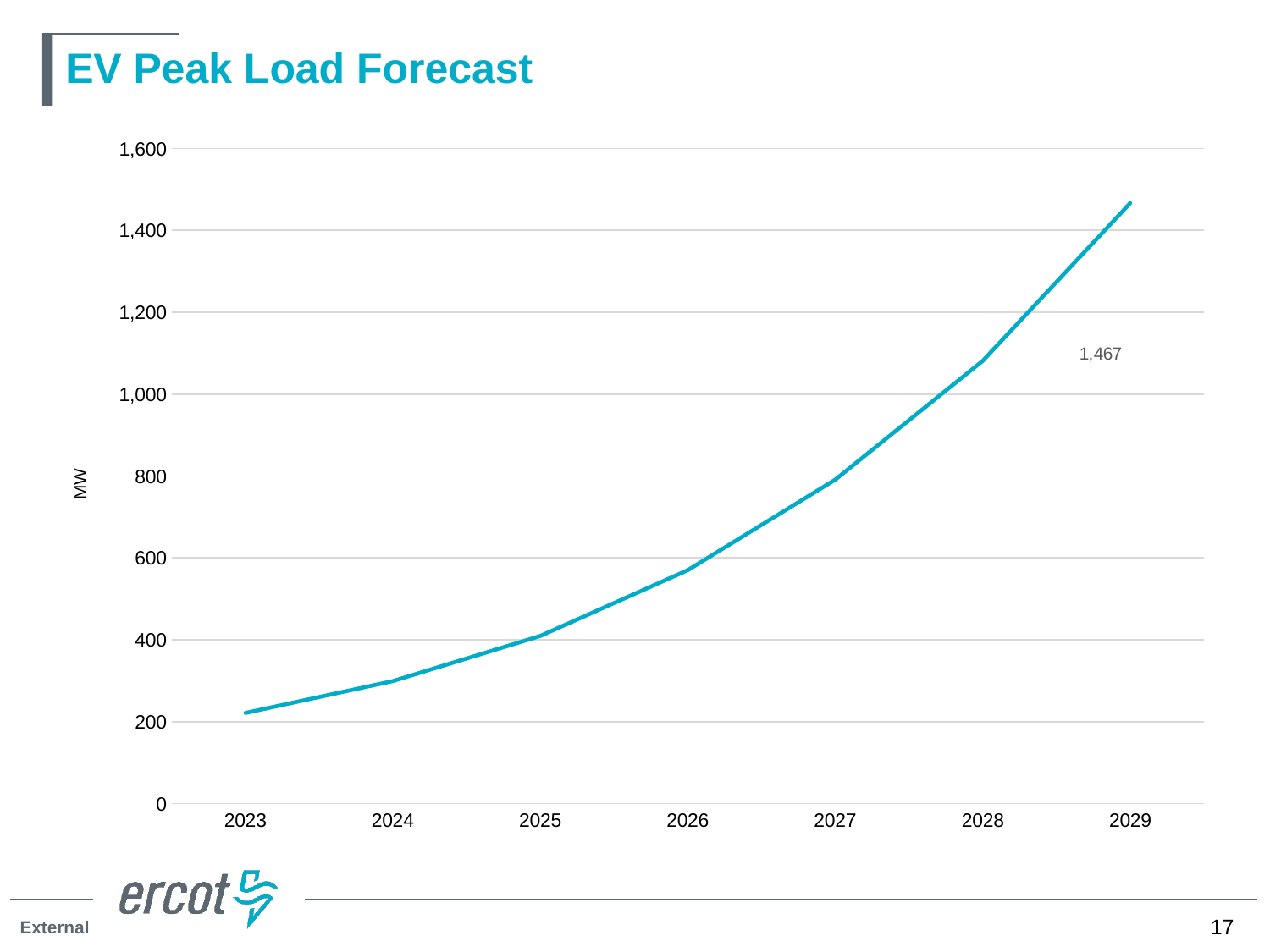
What unit is shown on the y axis label? MW Which year has the highest value on the EV Peak Load Forecast chart? 2029 What is the value for 2029 on the EV Peak Load Forecast chart? 1,467 Is the value for 2026 greater or less than 400? greater Do the values rise or fall from 2023 to 2029? Rise Is the value for 2023 greater or less than 400? less Is the value for 2028 greater or less than 1,000? greater Which year has the lowest value on the EV Peak Load Forecast chart? 2023 Which year has the larger value, 2026 or 2028? 2028 What kind of chart is shown on the slide? Line chart How many years are plotted on the x axis? 7